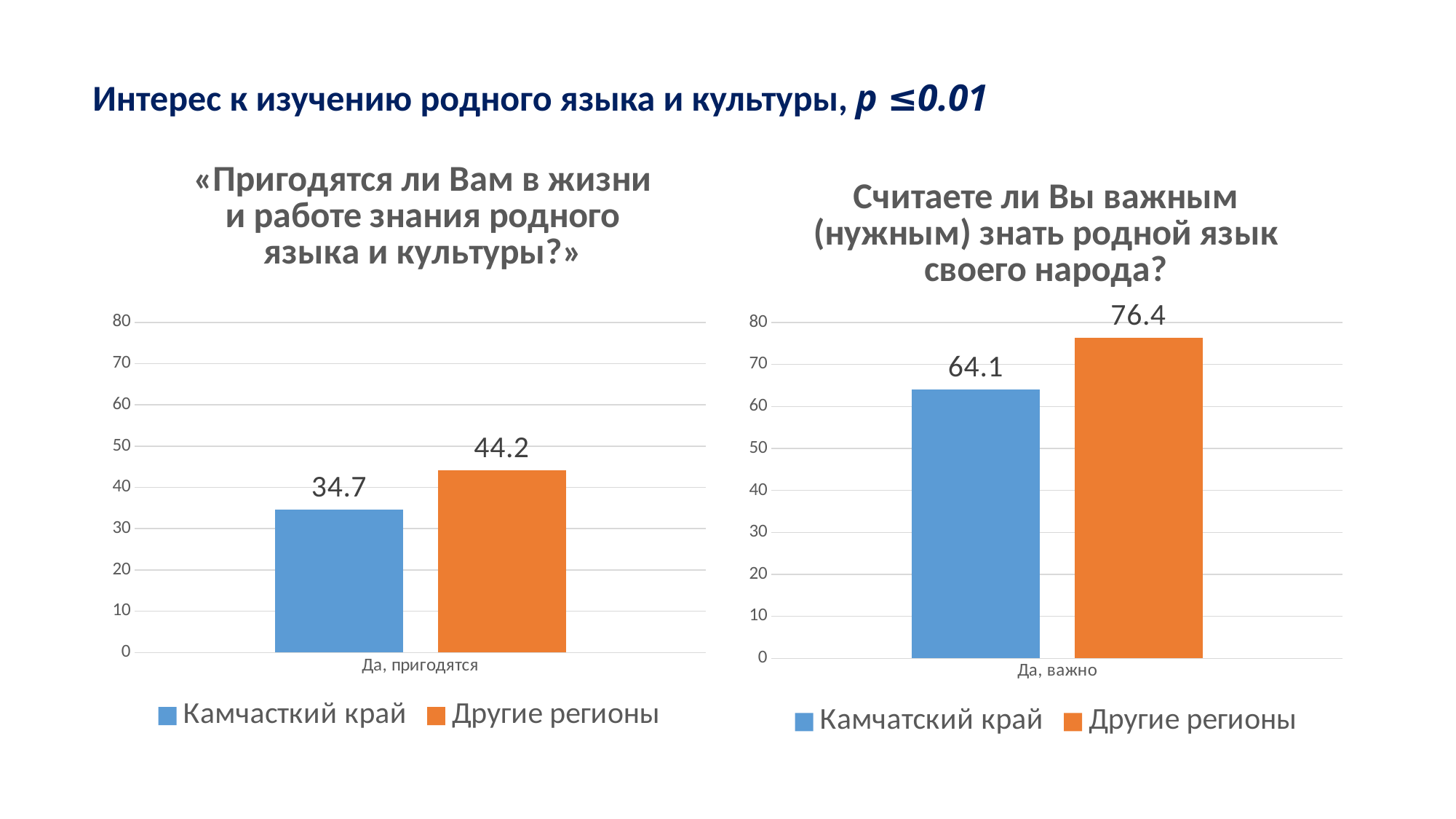
What is the category label on the x axis of the right chart? Да, важно In the right chart (Считаете ли Вы важным (нужным) знать родной язык своего народа?), what is the value for Камчатский край? 64.1 In the left chart, what is the difference between the values for Другие регионы and Камчастский край? 9.5 What kind of chart is the left chart? bar chart In the left chart («Пригодятся ли Вам в жизни и работе знания родного языка и культуры?»), what is the value for Камчастский край? 34.7 In the left chart, is the value for Другие регионы greater or less than 40? greater In the right chart (Считаете ли Вы важным (нужным) знать родной язык своего народа?), what is the value for Другие регионы? 76.4 How many series does the legend of the right chart list? 2 In the right chart, what is the difference between the values for Другие регионы and Камчатский край? 12.3 In the left chart, which series has the lower value? Камчастский край In the left chart («Пригодятся ли Вам в жизни и работе знания родного языка и культуры?»), what is the value for Другие регионы? 44.2 In the right chart, which series has the higher value: Камчатский край or Другие регионы? Другие регионы